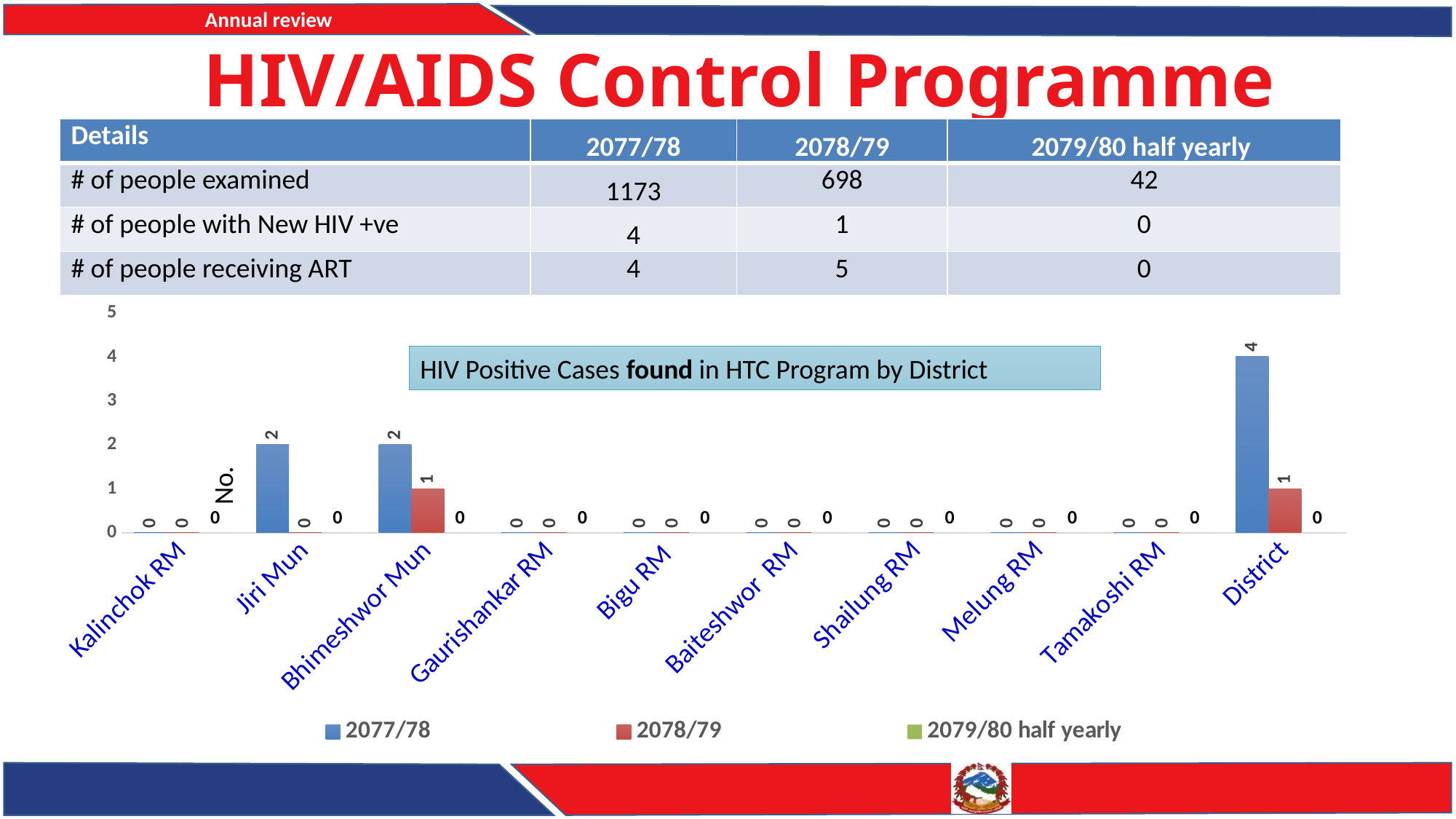
Which is larger for Bhimeshwor Mun: the 2077/78 value or the 2078/79 value? 2077/78 Which category has the highest value in the 2077/78 series? District What is the difference between the 2077/78 and 2078/79 values for District? 3 How many series does the chart legend list? 3 What is the title of the chart? HIV Positive Cases found in HTC Program by District What is the total of the three series values for Bhimeshwor Mun? 3 What is the value for Jiri Mun in the 2077/78 series? 2 How many categories are shown on the x axis of the chart? 10 What kind of chart is shown on the slide? Bar chart What is the value for Kalinchok RM in the 2079/80 half yearly series? 0 What is the value for District in the 2077/78 series? 4 What is the value for Bhimeshwor Mun in the 2078/79 series? 1